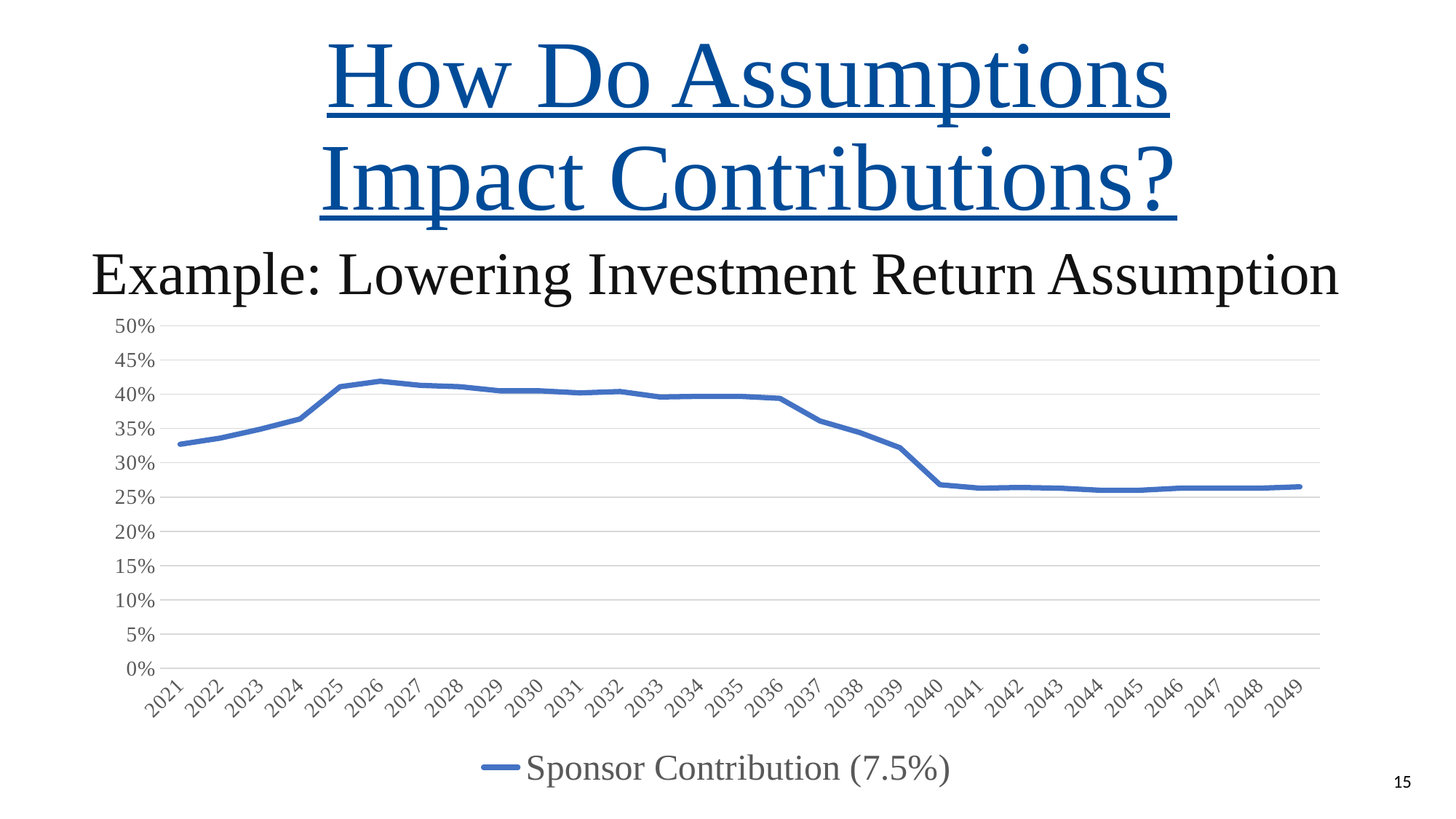
How many series does the legend list? 1 How many years are shown on the x axis? 29 Is the value for 2026 greater or less than 40%? greater What is the name of the series shown in the legend? Sponsor Contribution (7.5%) In which year does the Sponsor Contribution (7.5%) line reach its highest value? 2026 Is the value for 2021 greater or less than 30%? greater What kind of chart is shown on the slide? line chart Does the Sponsor Contribution (7.5%) line rise or fall between 2036 and 2040? fall Is the value for 2049 greater or less than 30%? less Which year has the larger value, 2026 or 2040? 2026 Does the Sponsor Contribution (7.5%) line rise or fall between 2021 and 2026? rise